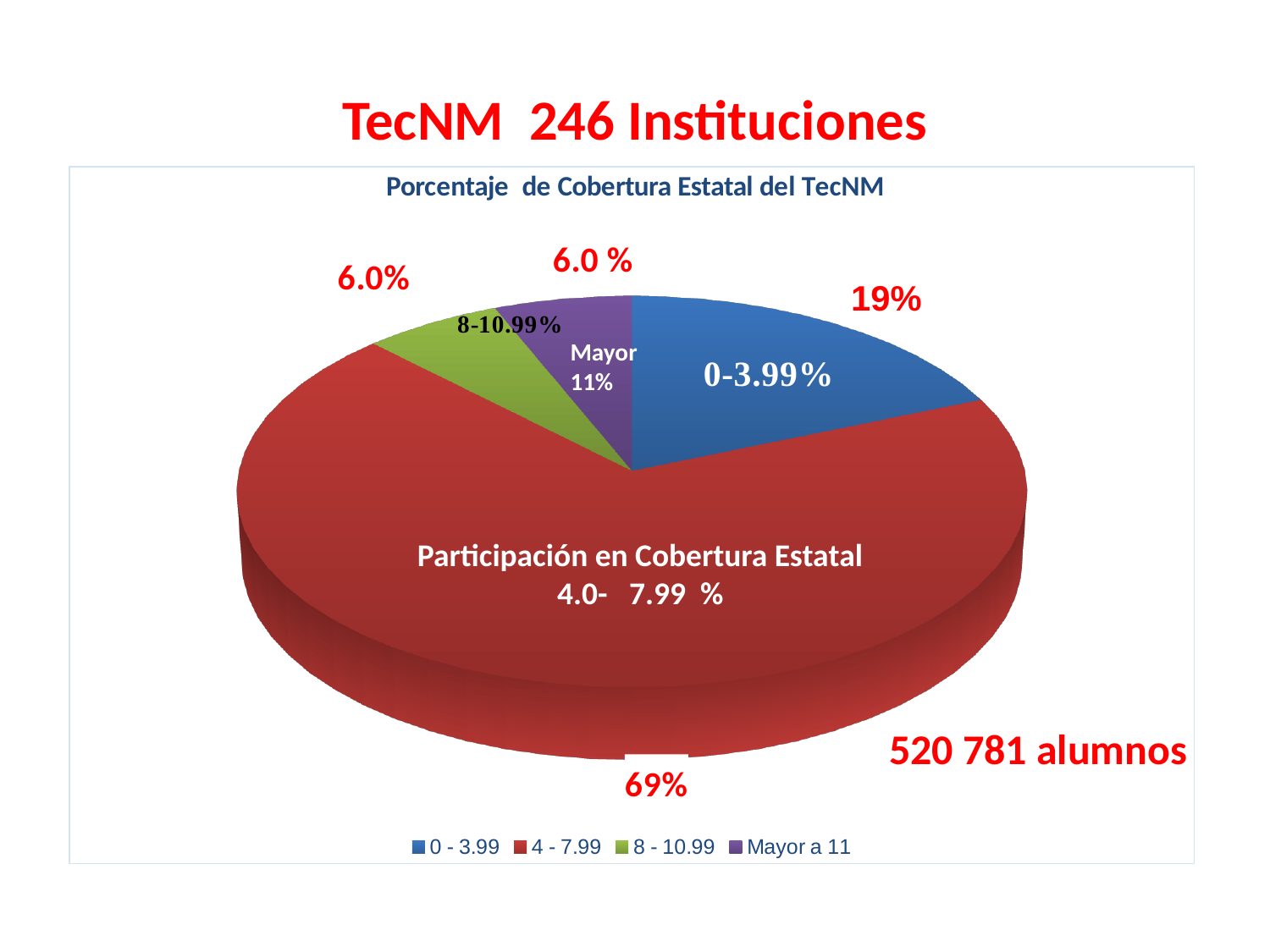
What percentage is shown for the 8 - 10.99 slice? 6.0% How many slices does the pie chart have? 4 What percentage does the 4 - 7.99 slice represent in the pie chart? 69% Which category has the largest share of the pie? 4 - 7.99 What is the title of the chart? Porcentaje de Cobertura Estatal del TecNM What percentage does the 0 - 3.99 slice represent? 19% What is the difference in percentage points between the 4 - 7.99 slice and the 0 - 3.99 slice? 50 What colour is the 4 - 7.99 slice? Red What kind of chart is shown on the slide? Pie chart Which is larger, the 0 - 3.99 slice or the 4 - 7.99 slice? 4 - 7.99 What percentage is shown for the Mayor a 11 slice? 6.0 % How many entries does the legend list? 4